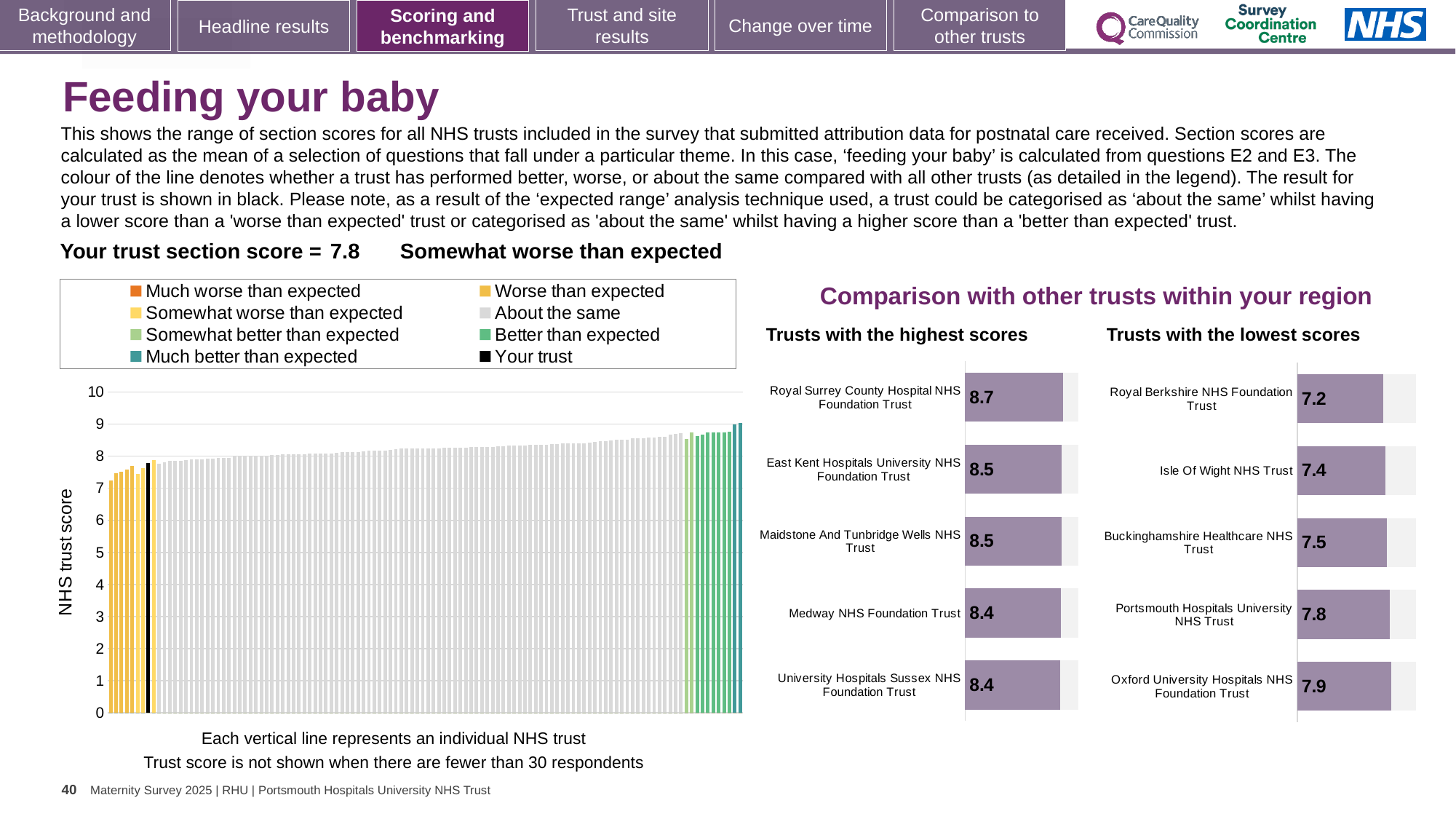
What kind of chart is the main 'NHS trust score' chart on the left? Bar chart In the 'Trusts with the lowest scores' chart, which trust has the lowest score? Royal Berkshire NHS Foundation Trust In the 'Trusts with the highest scores' chart, what is the difference between the scores of Royal Surrey County Hospital NHS Foundation Trust and Medway NHS Foundation Trust? 0.3 In the main 'NHS trust score' chart, do the values rise or fall from left to right? Rise In the 'Trusts with the lowest scores' chart, what is the score for Royal Berkshire NHS Foundation Trust? 7.2 In the 'Trusts with the highest scores' chart, what is the score for Royal Surrey County Hospital NHS Foundation Trust? 8.7 In the 'Trusts with the lowest scores' chart, what is the score for Portsmouth Hospitals University NHS Trust? 7.8 In the 'Trusts with the lowest scores' chart, what is the difference between the scores of Oxford University Hospitals NHS Foundation Trust and Royal Berkshire NHS Foundation Trust? 0.7 In the 'Trusts with the highest scores' chart, which trust has the highest score? Royal Surrey County Hospital NHS Foundation Trust How many entries does the legend of the main 'NHS trust score' chart list? 8 In the 'Trusts with the lowest scores' chart, which has the higher score: Isle Of Wight NHS Trust or Buckinghamshire Healthcare NHS Trust? Buckinghamshire Healthcare NHS Trust How many trusts are shown in the 'Trusts with the highest scores' chart? 5